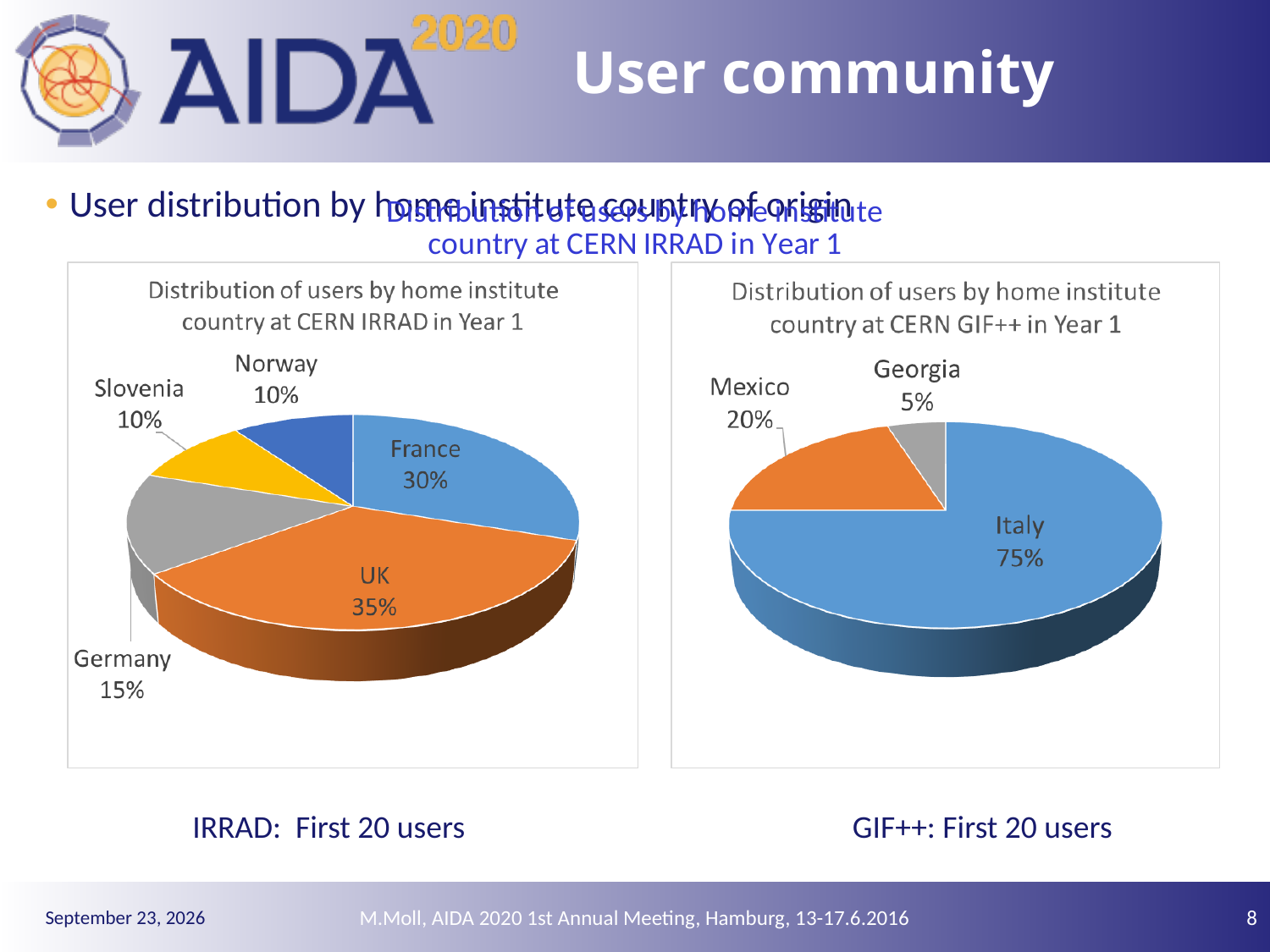
In the CERN IRRAD chart, what share of users come from Germany? 15% In the CERN IRRAD chart, how many countries are shown in the pie? 5 In the CERN IRRAD chart, which country has the largest share of users? UK In the CERN GIF++ chart, how many countries are shown in the pie? 3 In the CERN GIF++ chart, what share of users come from Mexico? 20% In the CERN GIF++ chart, what share of users come from Italy? 75% In the CERN GIF++ chart, what is the difference between the shares for Italy and Mexico? 55% What kind of chart is used on the right-hand side of the slide for CERN GIF++? Pie chart In the CERN IRRAD chart, which is larger, the share for France or the share for Germany? France In the CERN IRRAD chart, what share of users come from the UK? 35% In the CERN IRRAD chart, what is the difference between the shares for the UK and France? 5% In the CERN GIF++ chart, which country has the smallest share of users? Georgia